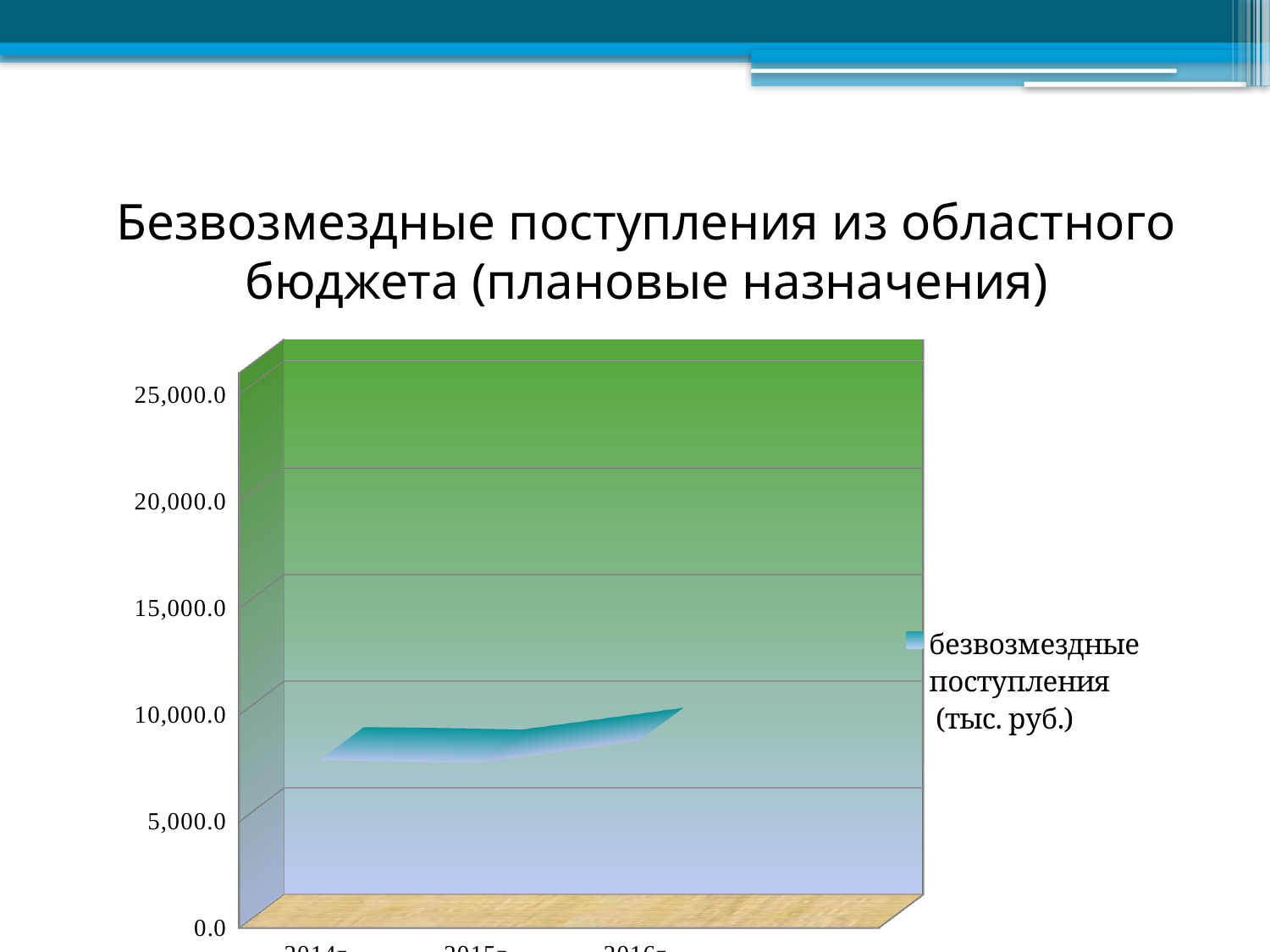
Which is larger, the value for 2015г or the value for 2016г? 2016г How many years are shown on the x axis? 3 How many series does the legend list? 1 Is the value for 2016г greater or less than 15,000.0? less What kind of chart is shown on the slide? line chart Is the value for 2014г greater or less than 5,000.0? greater Is the value for 2014г greater or less than 15,000.0? less What is the legend entry for the plotted series? безвозмездные поступления (тыс. руб.) Does the value rise or fall from 2015г to 2016г? rise What is the title of the chart? Безвозмездные поступления из областного бюджета (плановые назначения) Which year has the highest value? 2016г